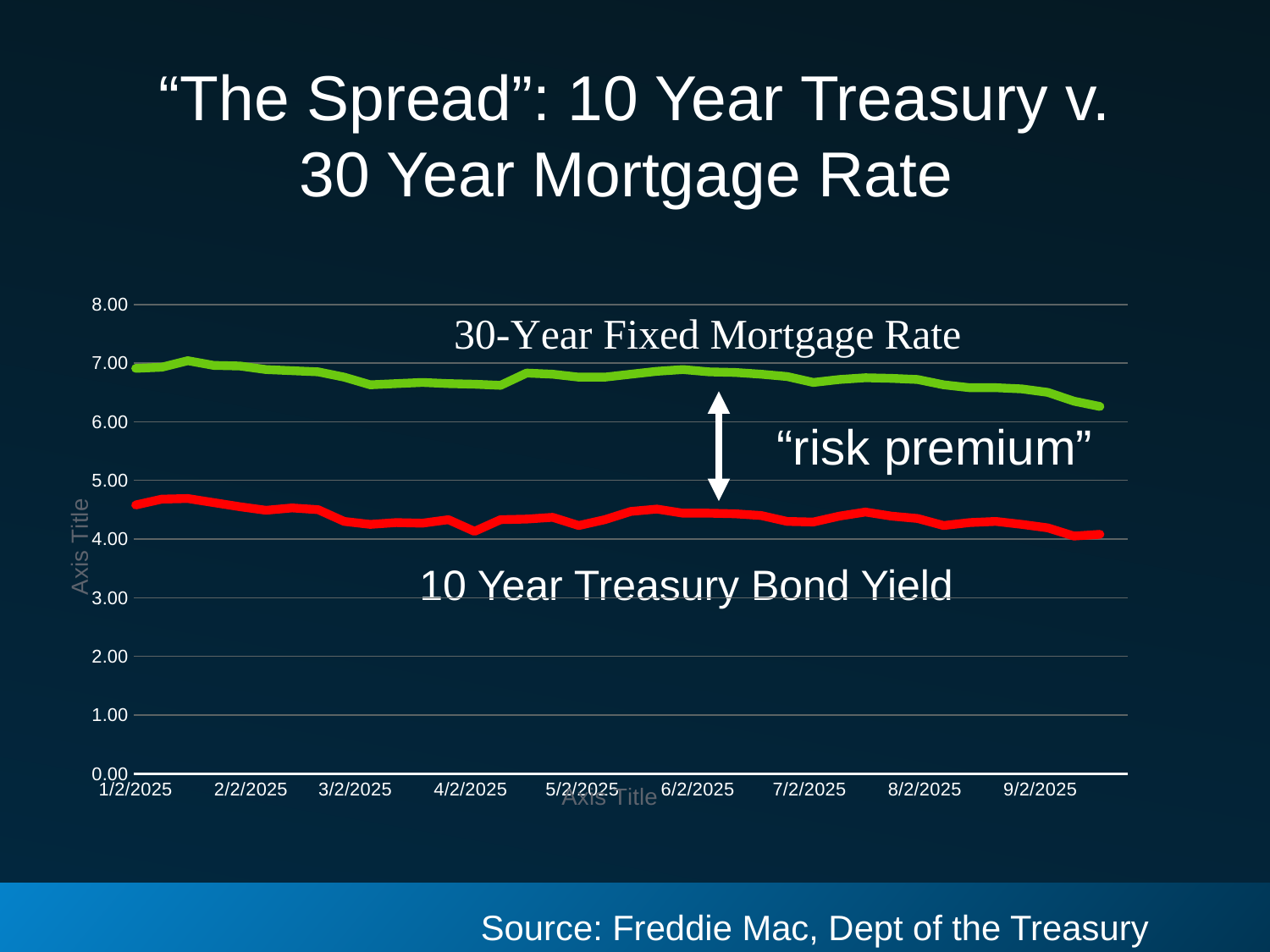
What colour is the line for the 10 Year Treasury Bond Yield? red Is the 10 Year Treasury Bond Yield at 6/2/2025 greater or less than 5.00? less How many data series are plotted on the chart? 2 Which series is plotted higher on the chart, the 30-Year Fixed Mortgage Rate or the 10 Year Treasury Bond Yield? 30-Year Fixed Mortgage Rate Does the 10 Year Treasury Bond Yield rise or fall overall from 1/2/2025 to 9/2/2025? fall What label is given to the gap between the two lines on the chart? "risk premium" Is the 30-Year Fixed Mortgage Rate at 3/2/2025 greater or less than 7.00? less What kind of chart is shown on the slide? line chart Is the 10 Year Treasury Bond Yield at 1/2/2025 greater or less than 5.00? less Does the 30-Year Fixed Mortgage Rate rise or fall overall from 1/2/2025 to 9/2/2025? fall How many date labels are shown on the x axis? 9